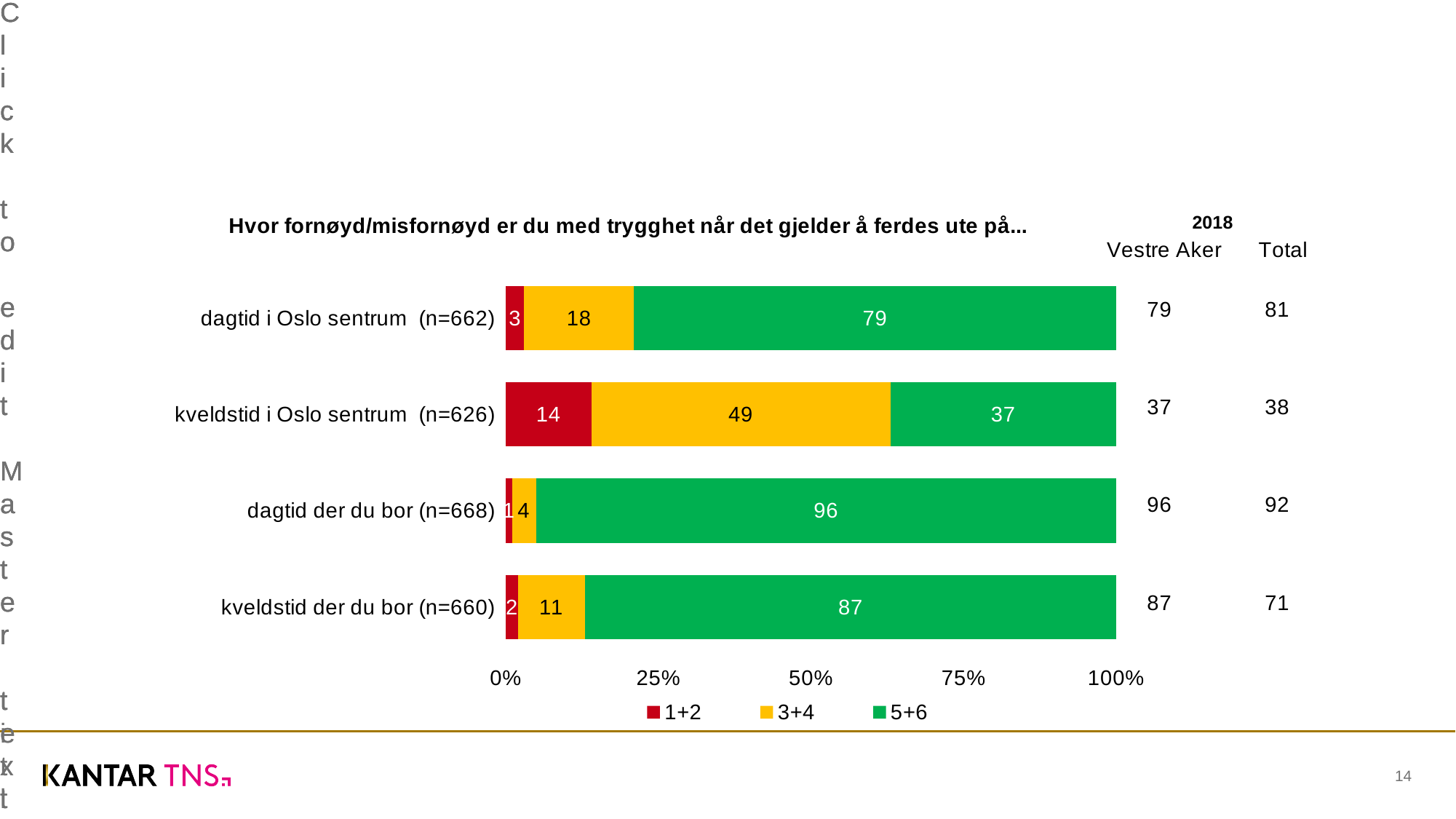
Which category has the lowest value for the 5+6 series? kveldstid i Oslo sentrum (n=626) What kind of chart is shown on the slide? stacked bar chart Which category has the highest value for the 5+6 series? dagtid der du bor (n=668) How many categories are shown on the chart? 4 What colour represents the 5+6 series in the legend? green What is the value of the 3+4 series for 'dagtid i Oslo sentrum (n=662)'? 18 What is the value of the 1+2 series for 'kveldstid i Oslo sentrum (n=626)'? 14 How many series does the legend list? 3 What is the value of the 5+6 series for 'kveldstid i Oslo sentrum (n=626)'? 37 Which is larger: the 3+4 value for 'kveldstid i Oslo sentrum (n=626)' or the 3+4 value for 'kveldstid der du bor (n=660)'? kveldstid i Oslo sentrum (n=626) What is the total of the stacked bar for 'dagtid i Oslo sentrum (n=662)'? 100 What is the difference between the 5+6 values for 'kveldstid der du bor (n=660)' and 'dagtid i Oslo sentrum (n=662)'? 8